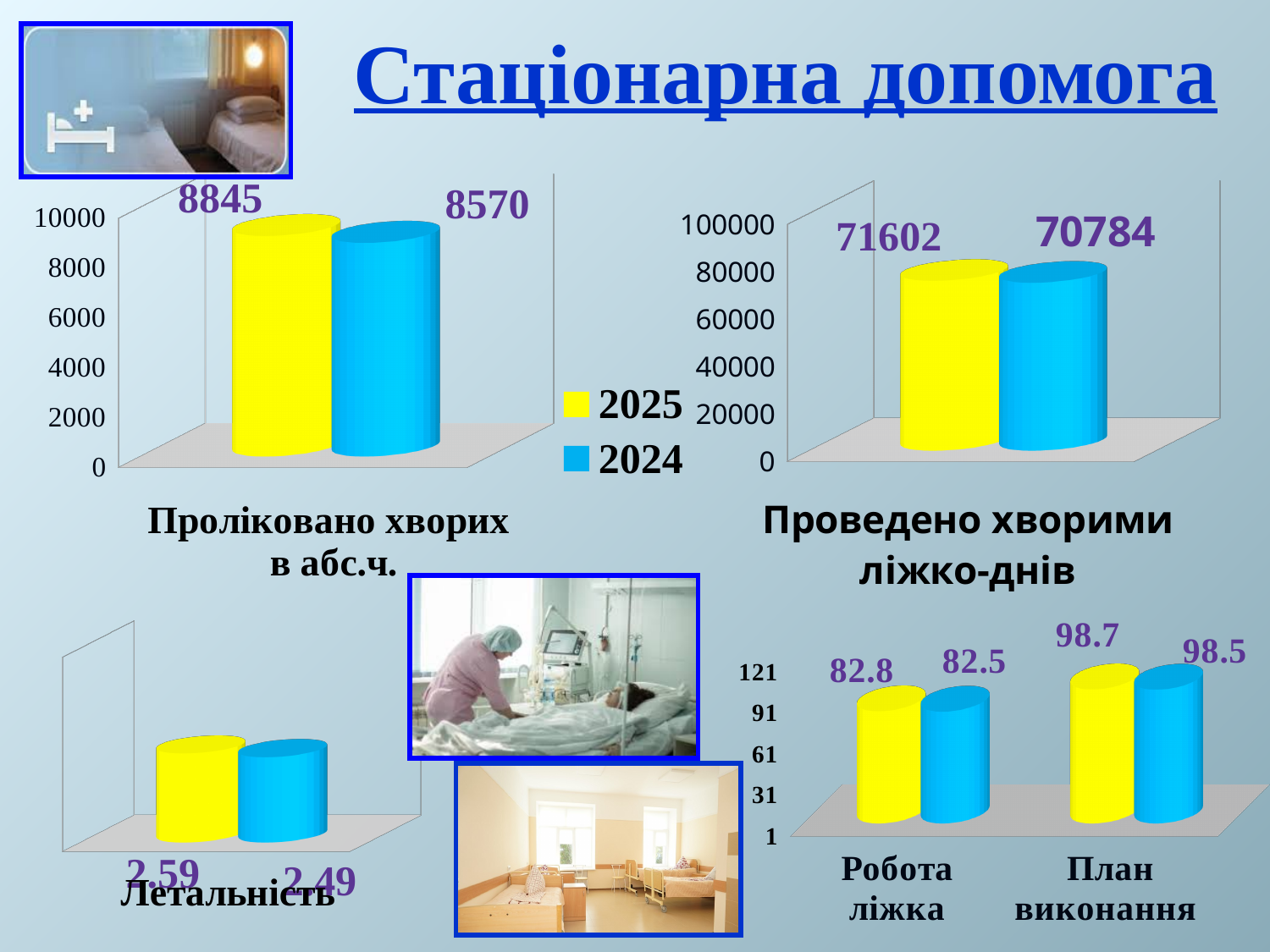
What kind of chart is the chart titled "Проліковано хворих в абс.ч."? Bar chart How many series does the legend on the slide list? 2 In the chart titled "Проліковано хворих в абс.ч.", what is the value for 2024? 8570 In the chart titled "Летальність", what is the value for 2025? 2.59 In the bottom-right chart, what is the 2025 value for "Робота ліжка"? 82.8 In the chart titled "Проведено хворими ліжко-днів", what is the value for 2024? 70784 In the chart titled "Проліковано хворих в абс.ч.", what is the value for 2025? 8845 In the chart titled "Проліковано хворих в абс.ч.", what is the difference between the 2025 and 2024 values? 275 In the bottom-right chart, what is the 2024 value for "План виконання"? 98.5 In the chart titled "Летальність", what is the value for 2024? 2.49 In the chart titled "Проведено хворими ліжко-днів", what is the value for 2025? 71602 In the chart titled "Проведено хворими ліжко-днів", which year has the higher value, 2025 or 2024? 2025